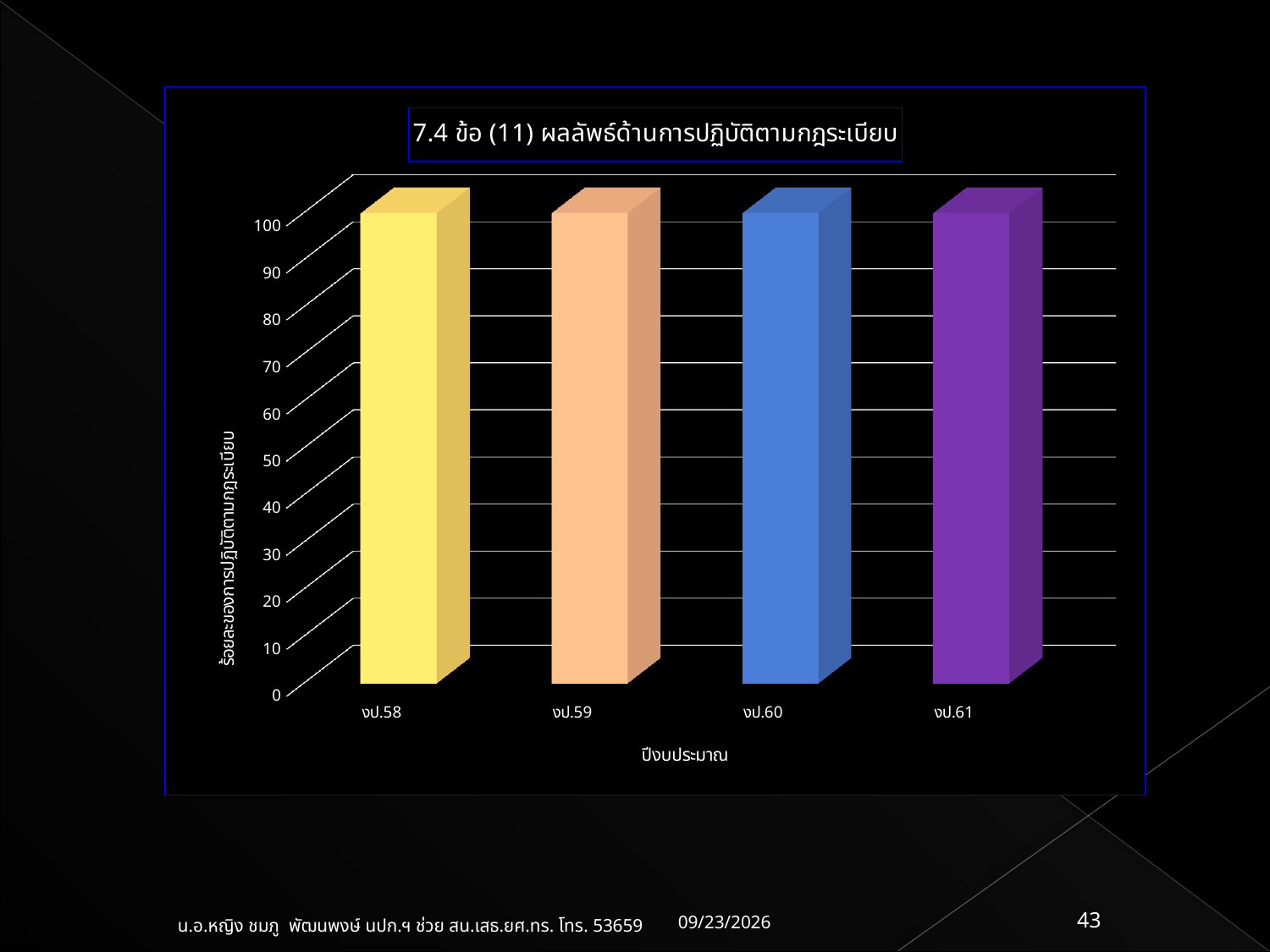
What type of chart is shown on the slide? bar chart Is the value for งป.60 greater or less than 50? greater Is the value for งป.59 greater or less than 90? greater How many categories (fiscal years) are shown on the x axis? 4 What is the title of the chart? 7.4 ข้อ (11) ผลลัพธ์ด้านการปฏิบัติตามกฎระเบียบ What is the highest value shown on the y axis? 100 What is the value for งป.61? 100 Do the values rise, fall, or stay flat from งป.58 to งป.61? stay flat What is the value for งป.58? 100 What is the difference between the values for งป.58 and งป.61? 0 What is the label of the x axis? ปีงบประมาณ